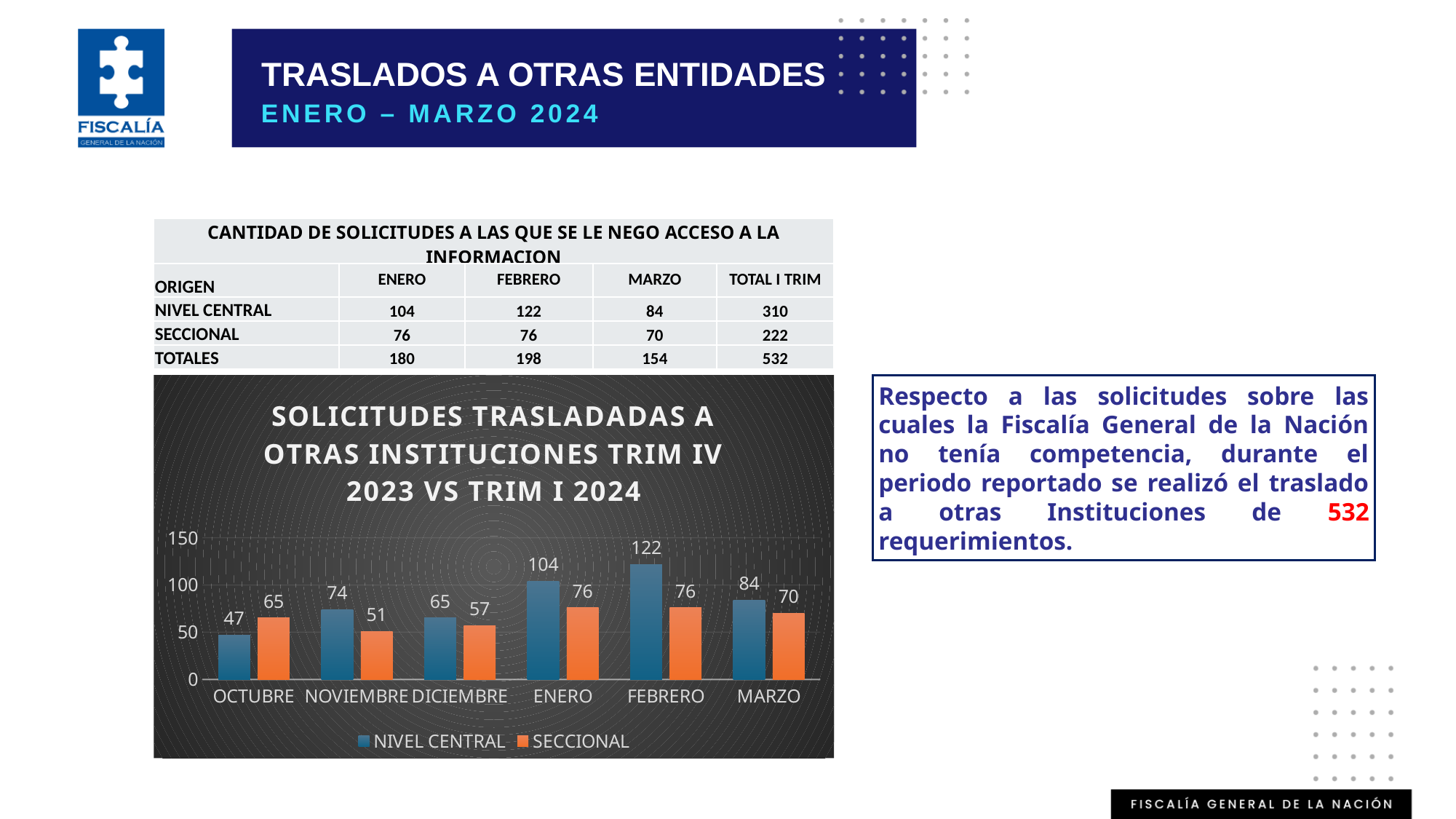
What is the value for NIVEL CENTRAL in ENERO? 104 Which is larger in OCTUBRE, NIVEL CENTRAL or SECCIONAL? SECCIONAL Which month has the highest NIVEL CENTRAL value? FEBRERO Which month has the lowest NIVEL CENTRAL value? OCTUBRE What is the value for NIVEL CENTRAL in MARZO? 84 What is the difference between NIVEL CENTRAL and SECCIONAL in FEBRERO? 46 How many months are shown on the x axis of the chart? 6 What kind of chart is shown on the slide? Bar chart How many series does the chart legend list? 2 Is the value for NIVEL CENTRAL in FEBRERO greater or less than 100? greater What is the value for SECCIONAL in OCTUBRE? 65 Which month has the lowest SECCIONAL value? NOVIEMBRE